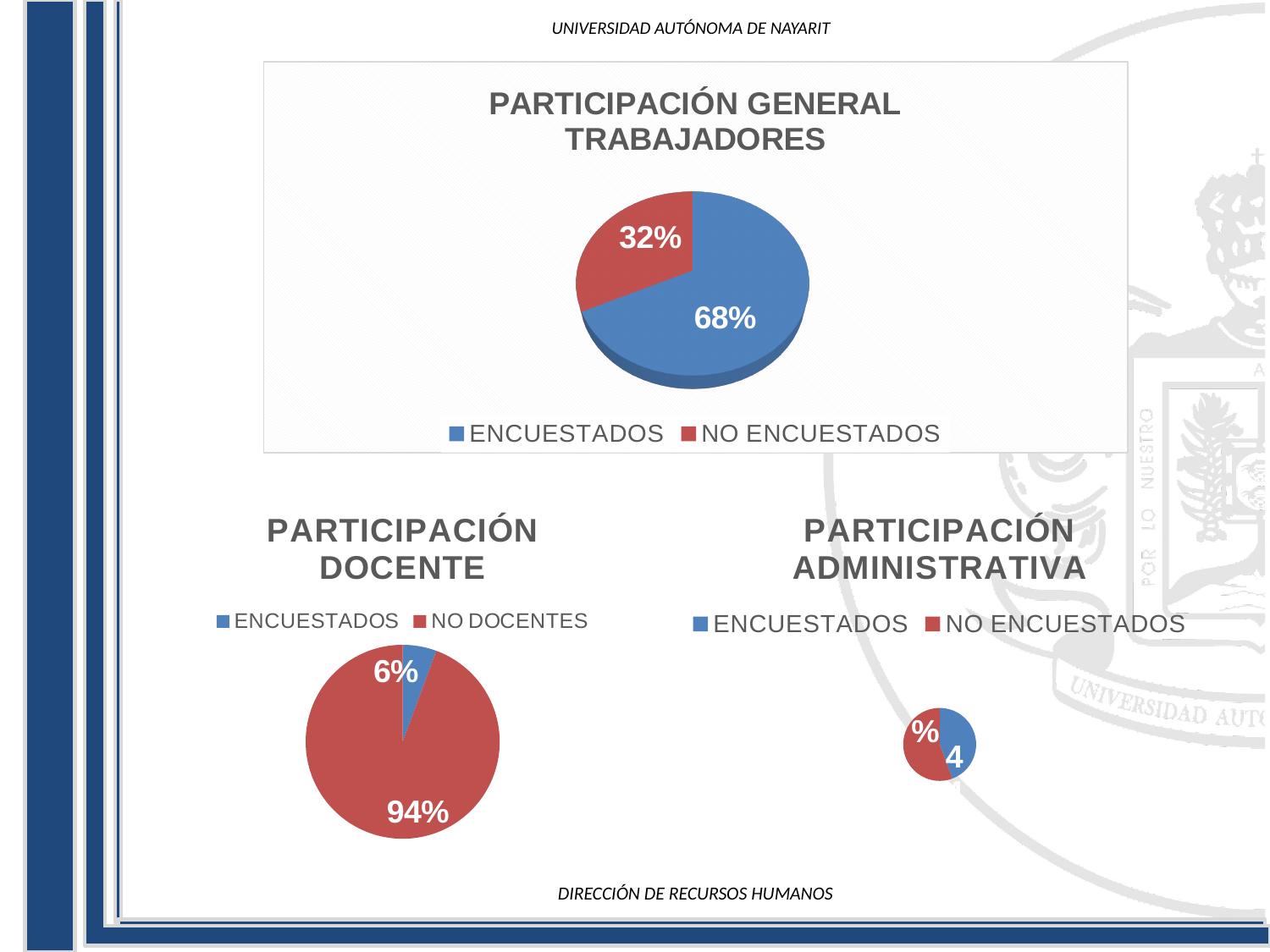
How many entries does the legend of the PARTICIPACIÓN ADMINISTRATIVA chart list? 2 In the PARTICIPACIÓN GENERAL TRABAJADORES chart, which slice is the largest? ENCUESTADOS What colour represents ENCUESTADOS in the PARTICIPACIÓN ADMINISTRATIVA chart? Blue In the PARTICIPACIÓN DOCENTE chart, which slice is the smallest? ENCUESTADOS In the PARTICIPACIÓN DOCENTE chart, what percentage is ENCUESTADOS? 6% In the PARTICIPACIÓN GENERAL TRABAJADORES chart, what is the difference between the ENCUESTADOS and NO ENCUESTADOS shares? 36% In the PARTICIPACIÓN GENERAL TRABAJADORES chart, what percentage is NO ENCUESTADOS? 32% In the PARTICIPACIÓN GENERAL TRABAJADORES chart, what percentage is ENCUESTADOS? 68% What kind of chart is the PARTICIPACIÓN GENERAL TRABAJADORES chart? Pie chart In the PARTICIPACIÓN DOCENTE chart, which is larger, ENCUESTADOS or NO DOCENTES? NO DOCENTES How many slices does the PARTICIPACIÓN DOCENTE chart have? 2 In the PARTICIPACIÓN DOCENTE chart, what percentage is NO DOCENTES? 94%